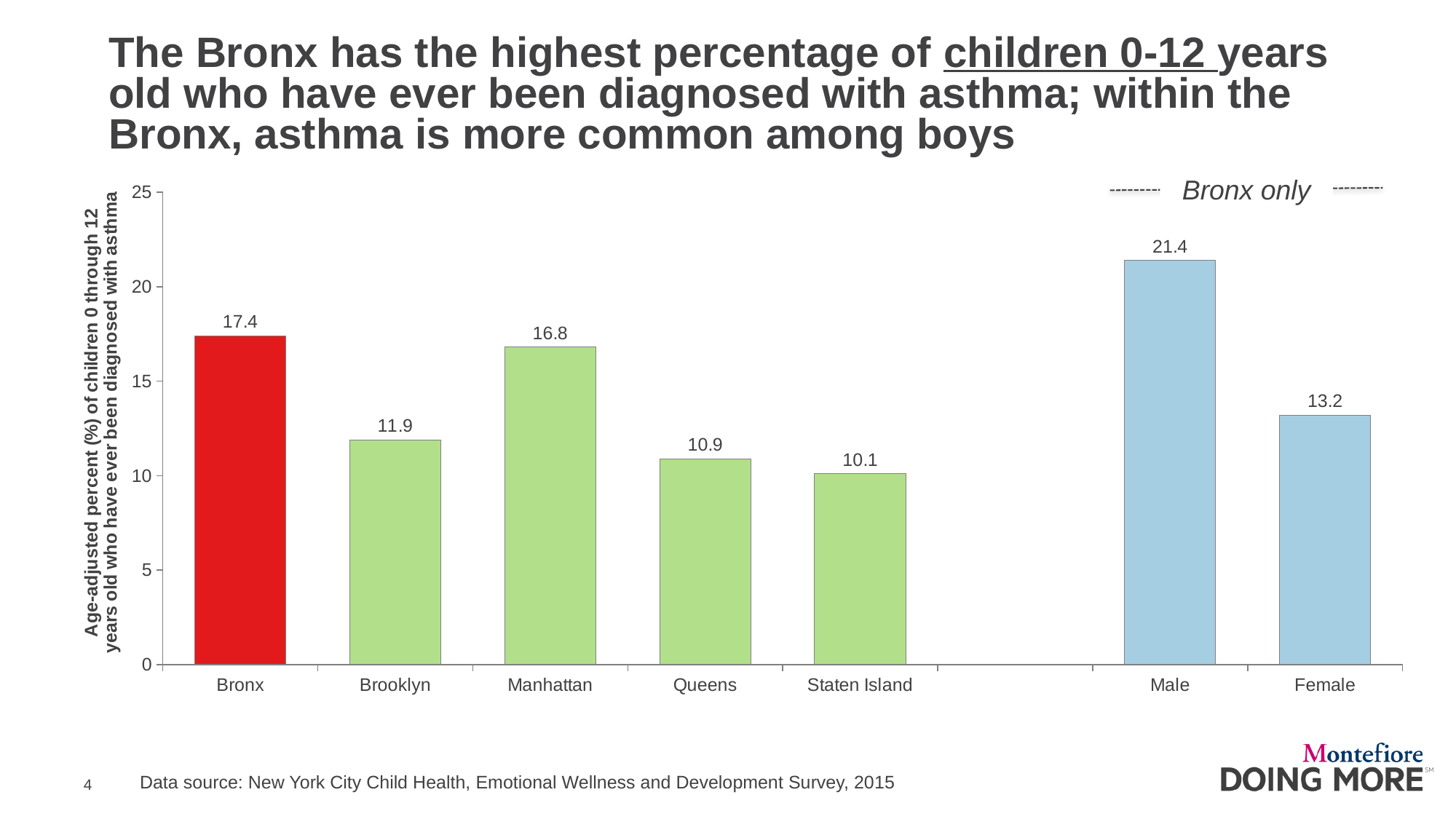
What is the value for the Bronx? 17.4 What colour is the Bronx bar? red What is the value for Staten Island? 10.1 What is the value for Male in the Bronx only section? 21.4 What is the difference between the Male and Female values in the Bronx? 8.2 Which of the five boroughs has the highest value? Bronx Which is larger, the value for Brooklyn or the value for Queens? Brooklyn Is the value for Male greater or less than 20? greater What kind of chart is shown on the slide? bar chart How many bars are plotted on the chart? 7 Which of the five boroughs has the lowest value? Staten Island What is the difference between the Bronx and Manhattan values? 0.6